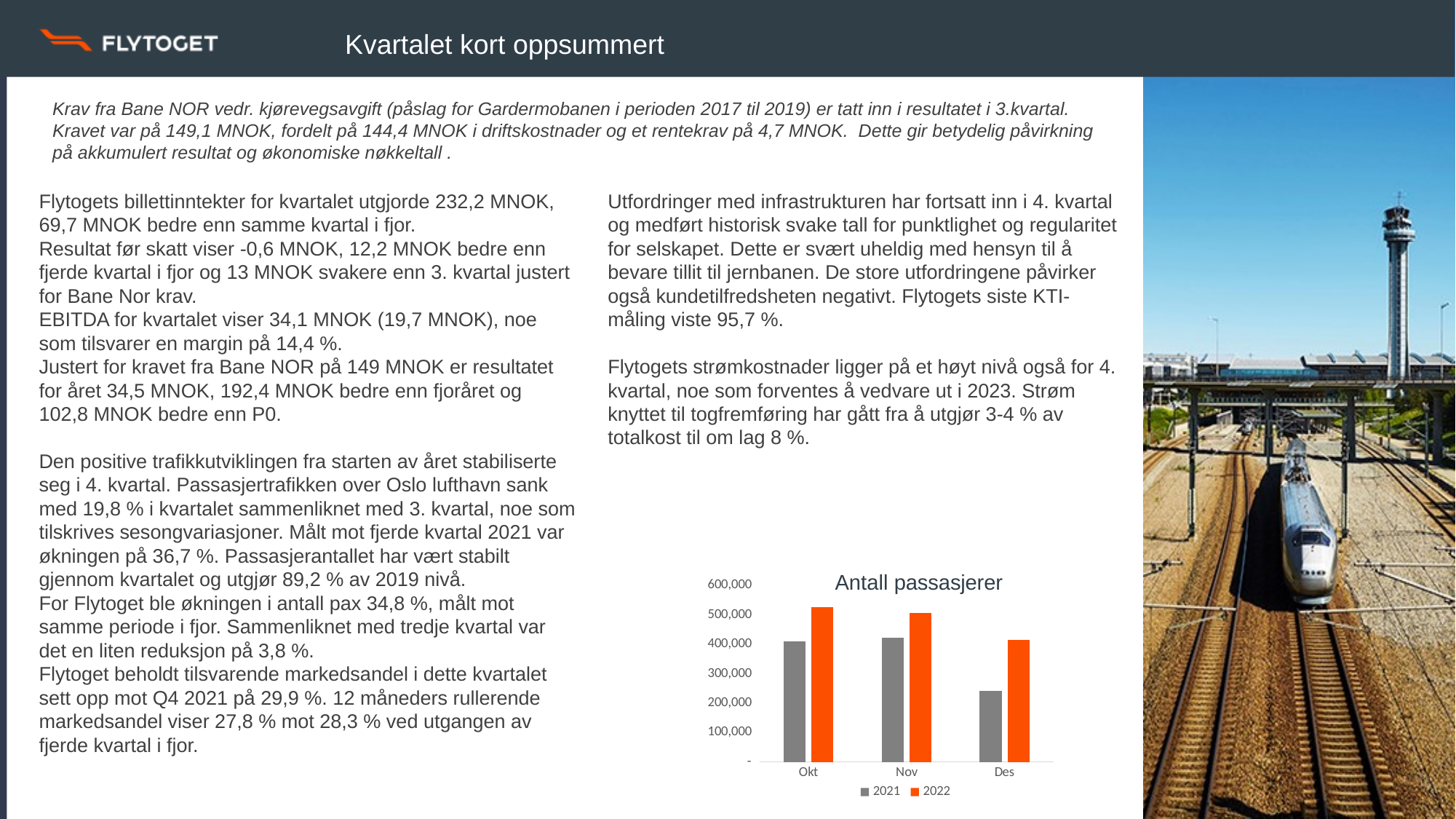
Which series is shown in orange in the chart? 2022 Is the value for Des in the 2022 series greater or less than 500,000? less Is the value for Okt in the 2022 series greater or less than 500,000? greater What kind of chart is shown on the slide? Bar chart For Des, which series has the larger value, 2021 or 2022? 2022 Which month has the highest value in the 2022 series? Okt How many series does the chart legend list? 2 Is the value for Des in the 2021 series greater or less than 300,000? less Which month has the lowest value in the 2021 series? Des What is the title of the chart? Antall passasjerer How many months are shown on the x axis of the chart? 3